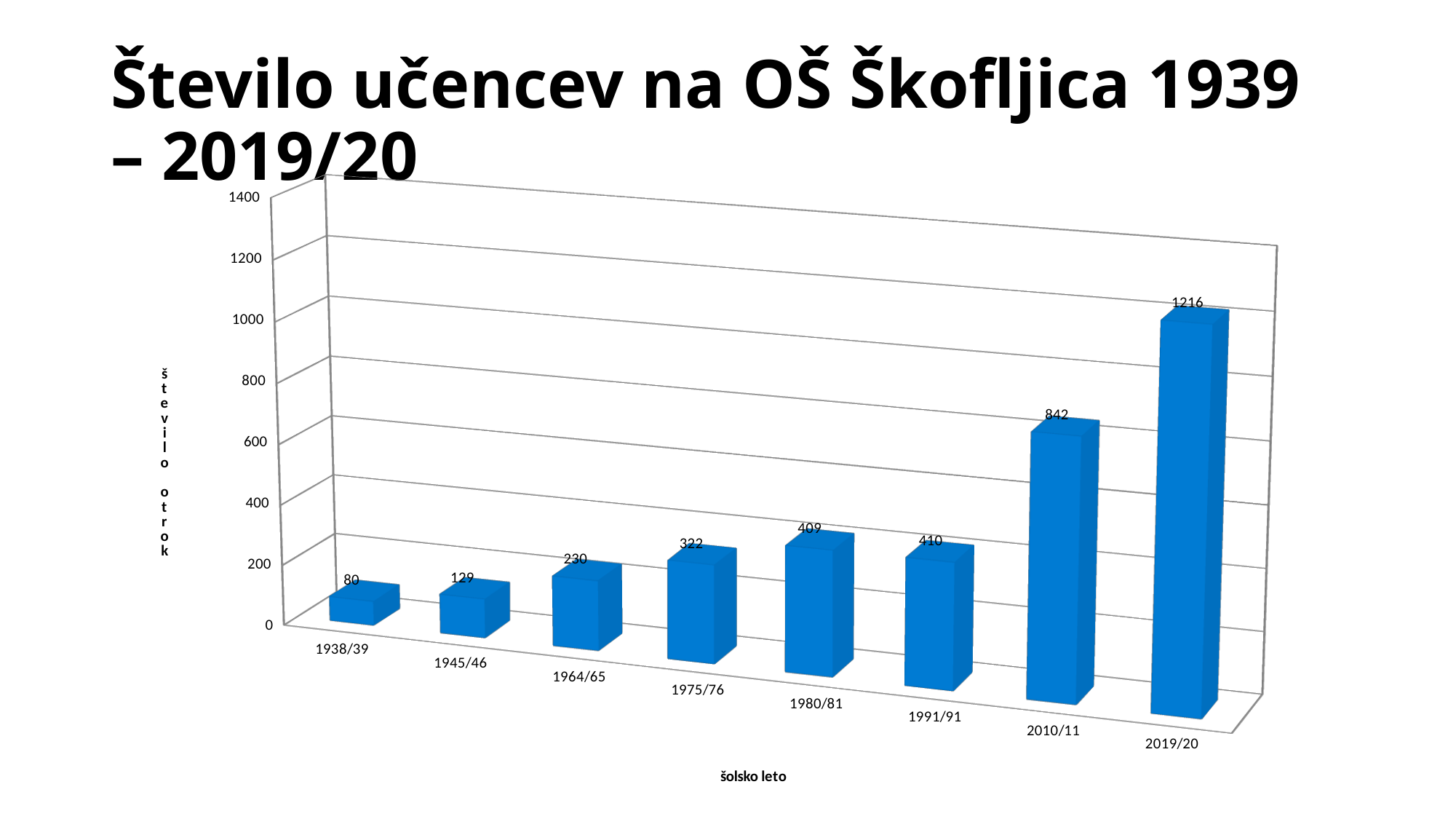
Which school year has more pupils, 1980/81 or 1975/76? 1980/81 Which school year has the lowest number of pupils? 1938/39 Which school year has the highest number of pupils? 2019/20 What is the difference between the number of pupils in 1964/65 and 1945/46? 101 Do the values rise or fall from 1938/39 to 2019/20? rise What is the number of pupils for the school year 2010/11? 842 What is the number of pupils for the school year 1975/76? 322 What is the number of pupils for the school year 1938/39? 80 What is the difference between the number of pupils in 2019/20 and 2010/11? 374 How many school years are shown on the chart? 8 What kind of chart is shown on the slide? bar chart What is the label of the x axis? šolsko leto